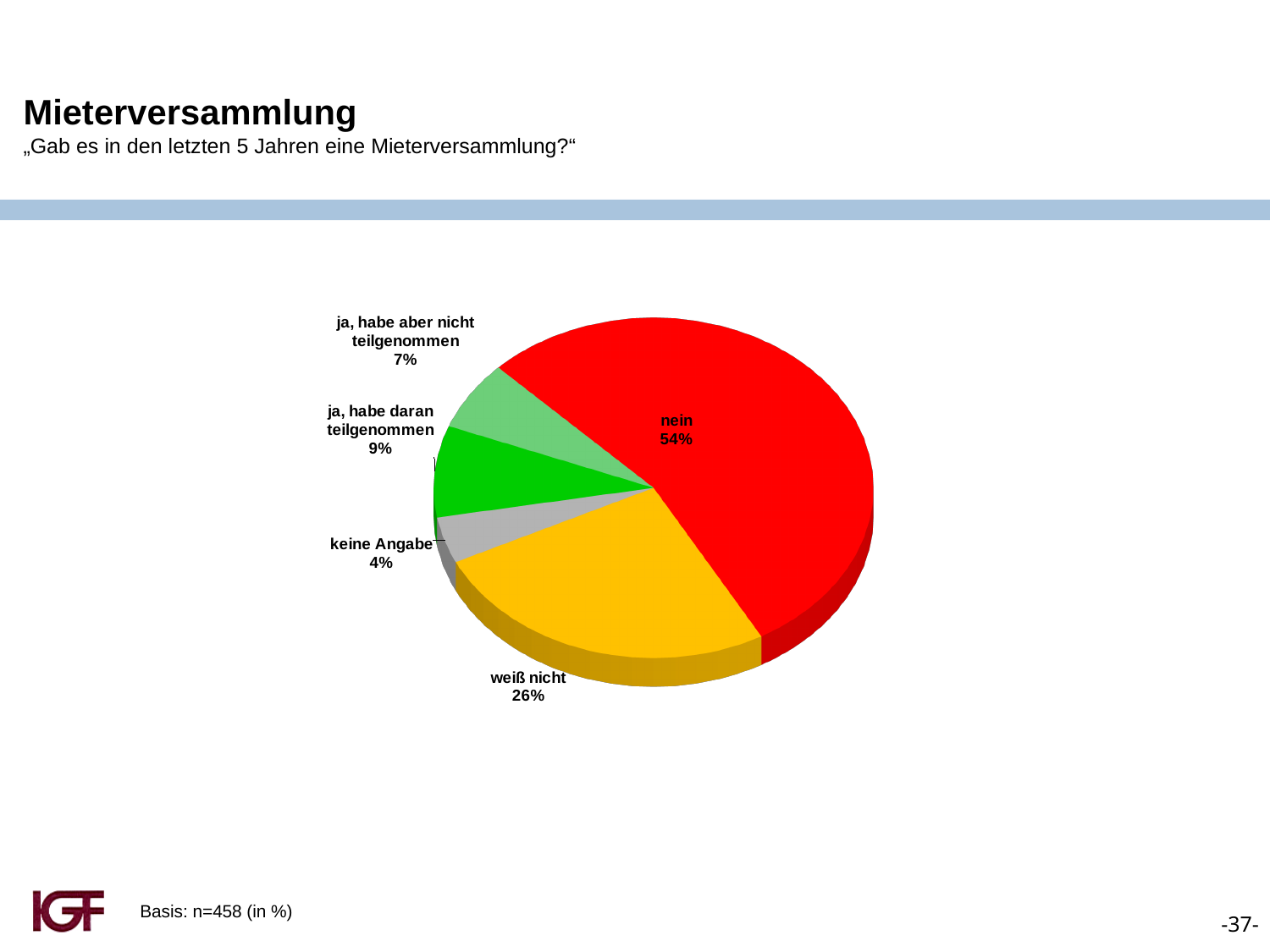
How many slices does the pie chart have? 5 What percentage of respondents answered "ja, habe aber nicht teilgenommen"? 7% Which is larger: the share for "ja, habe daran teilgenommen" or for "ja, habe aber nicht teilgenommen"? ja, habe daran teilgenommen What is the difference in percentage points between "nein" and "weiß nicht"? 28 What percentage of respondents gave "keine Angabe"? 4% Which answer category has the smallest share of the pie? keine Angabe What percentage of respondents answered "nein"? 54% What percentage of respondents answered "ja, habe daran teilgenommen"? 9% What colour is the "nein" slice? red What kind of chart is shown on the slide? pie chart What percentage of respondents answered "weiß nicht"? 26% Which answer category has the largest share of the pie? nein